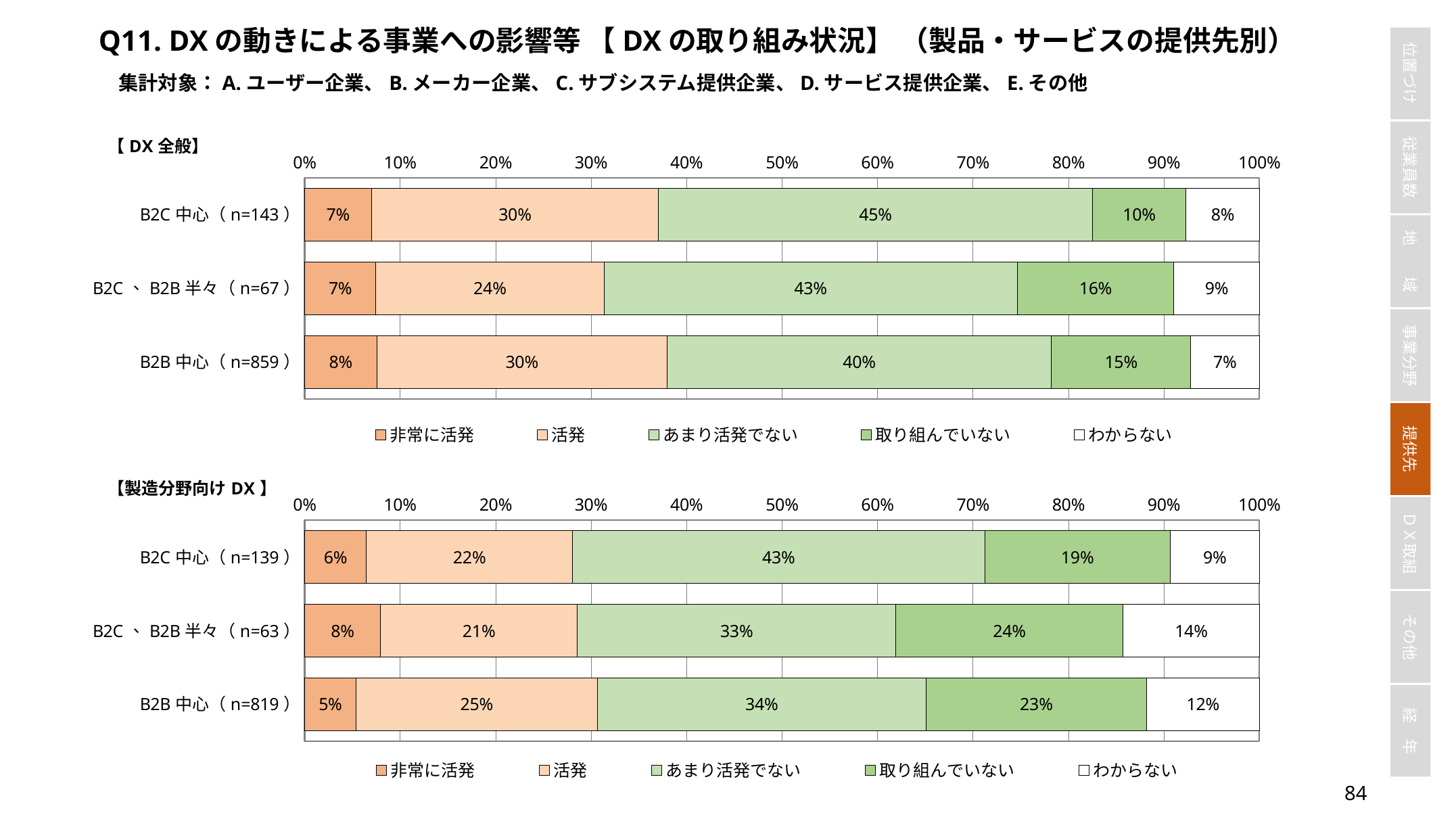
How many categories are shown in the 【製造分野向けDX】 chart? 3 In the 【DX全般】 chart, which category has the highest value for あまり活発でない? B2C中心（n=143） In the 【製造分野向けDX】 chart, what is the difference between the 取り組んでいない values for B2C、B2B半々（n=63） and B2C中心（n=139）? 5% In the 【製造分野向けDX】 chart, which category has the lowest value for 非常に活発? B2B中心（n=819） In the 【製造分野向けDX】 chart, what is the value of あまり活発でない for B2B中心（n=819）? 34% How many series does the legend of the 【DX全般】 chart list? 5 In the 【DX全般】 chart, which is larger: the 取り組んでいない value for B2C中心（n=143） or for B2B中心（n=859）? B2B中心（n=859） In the 【製造分野向けDX】 chart, what is the value of わからない for B2C、B2B半々（n=63）? 14% In the 【DX全般】 chart, what is the value of 活発 for B2C中心（n=143）? 30% In the 【DX全般】 chart, what is the value of 取り組んでいない for B2C、B2B半々（n=67）? 16% In the 【製造分野向けDX】 chart, what is the combined total of 非常に活発 and 活発 for B2B中心（n=819）? 30% What kind of chart is the 【DX全般】 chart? Stacked bar chart